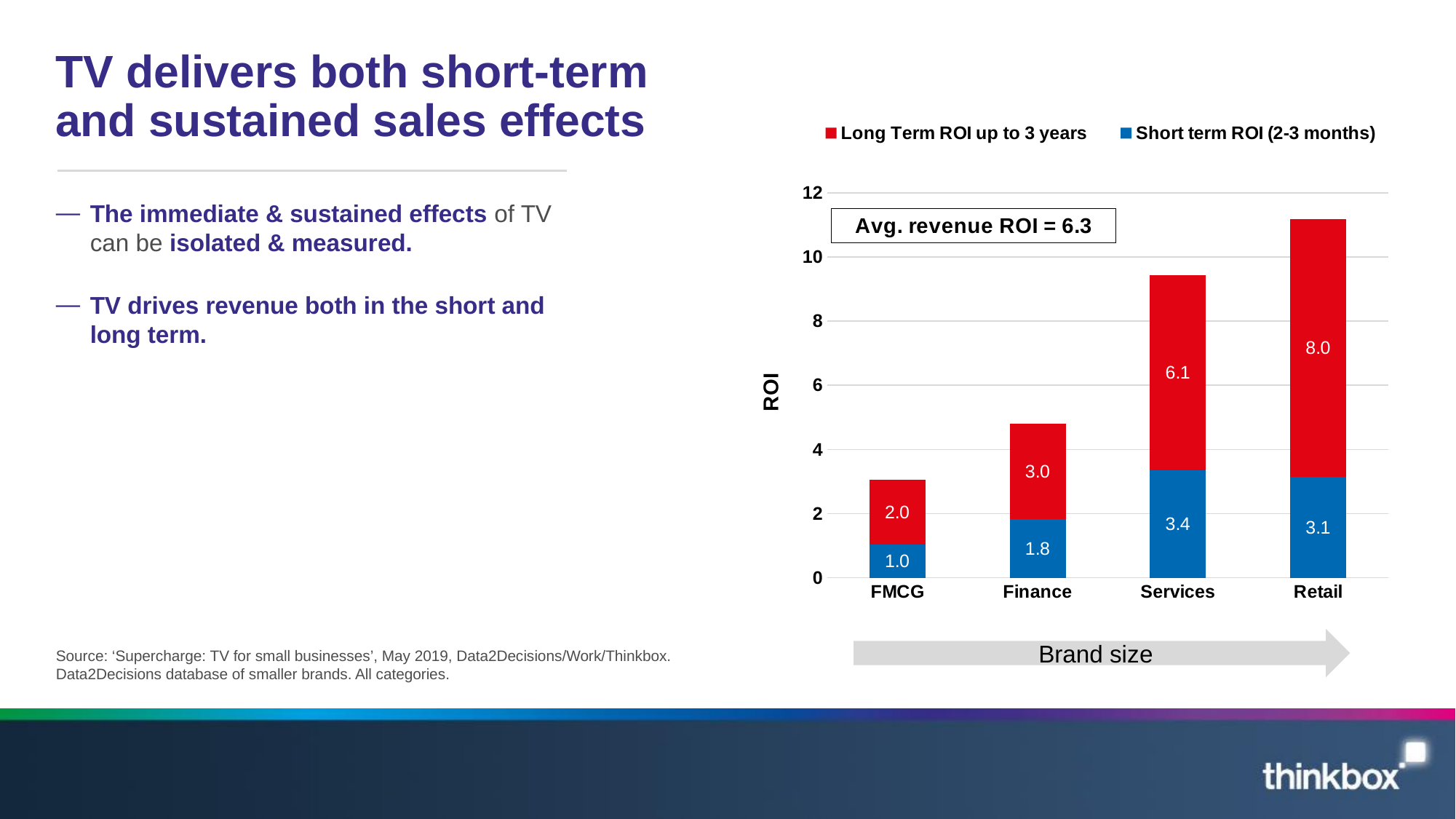
What is the Short term ROI (2-3 months) value for Retail? 3.1 Which is larger: the Short term ROI for Services or the Short term ROI for Retail? Services Which category has the lowest Short term ROI (2-3 months)? FMCG What type of chart is shown on the slide? Stacked bar chart What is the total ROI of the stacked bar for Retail? 11.1 Which category has the highest Long Term ROI up to 3 years? Retail What is the difference between the Long Term ROI for Retail and the Long Term ROI for FMCG? 6.0 How many series does the chart legend list? 2 What is the Short term ROI (2-3 months) value for Finance? 1.8 What is the Long Term ROI up to 3 years value for Services? 6.1 What is the total ROI of the stacked bar for Finance? 4.8 How many categories are shown on the x axis of the chart? 4